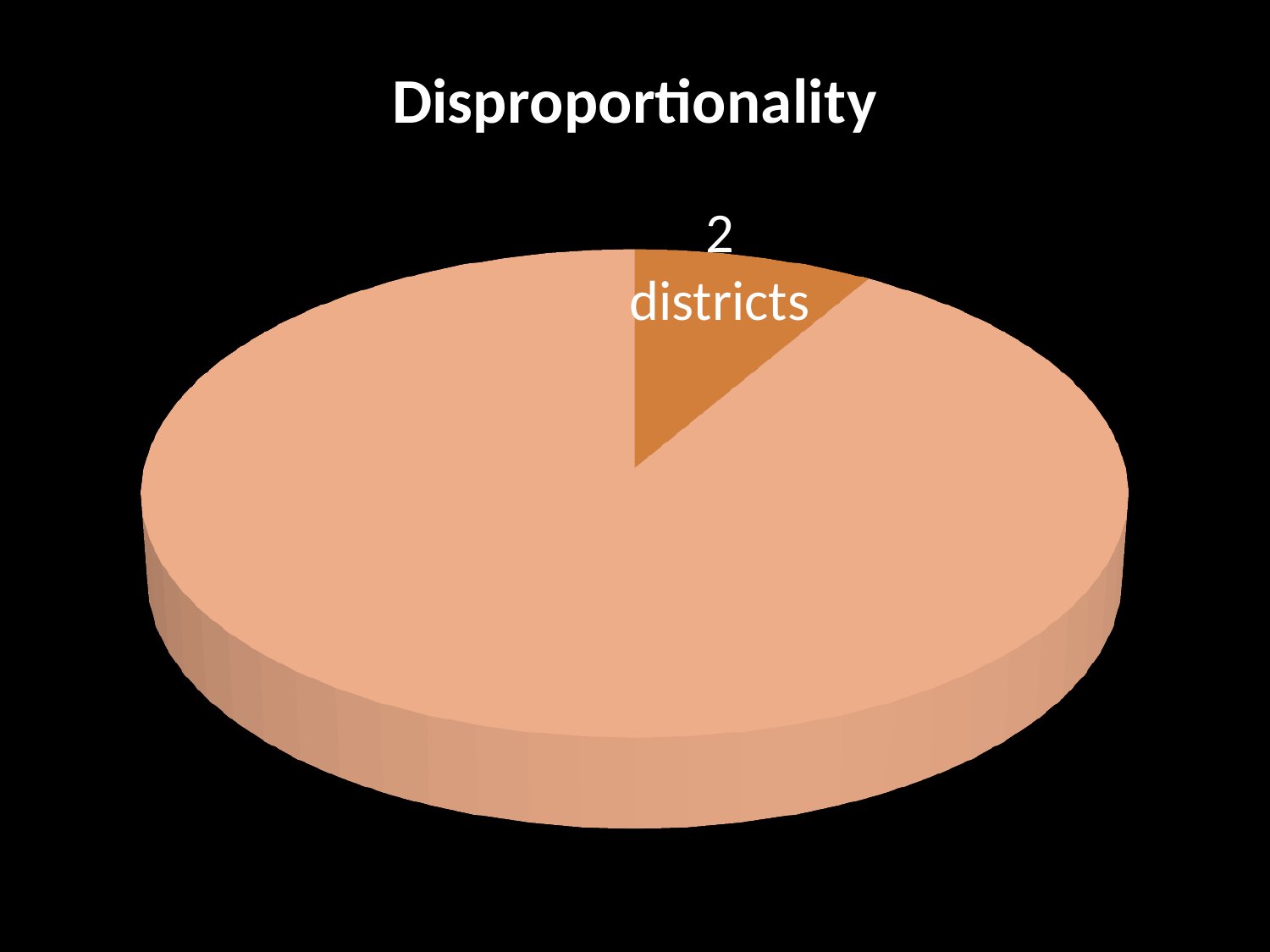
What is the title of the chart? Disproportionality Does the chart include a legend? No How many slices does the pie chart have? 2 Which slice is the largest: the one labelled "2 districts" or the unlabelled light-coloured slice? the unlabelled light-coloured slice Does the slice labelled "2 districts" make up more or less than half of the pie? less What kind of chart is shown on the slide? pie chart Is the slice labelled "2 districts" the larger or the smaller slice of the pie? smaller What label is printed on the small, darker orange slice of the pie? 2 districts